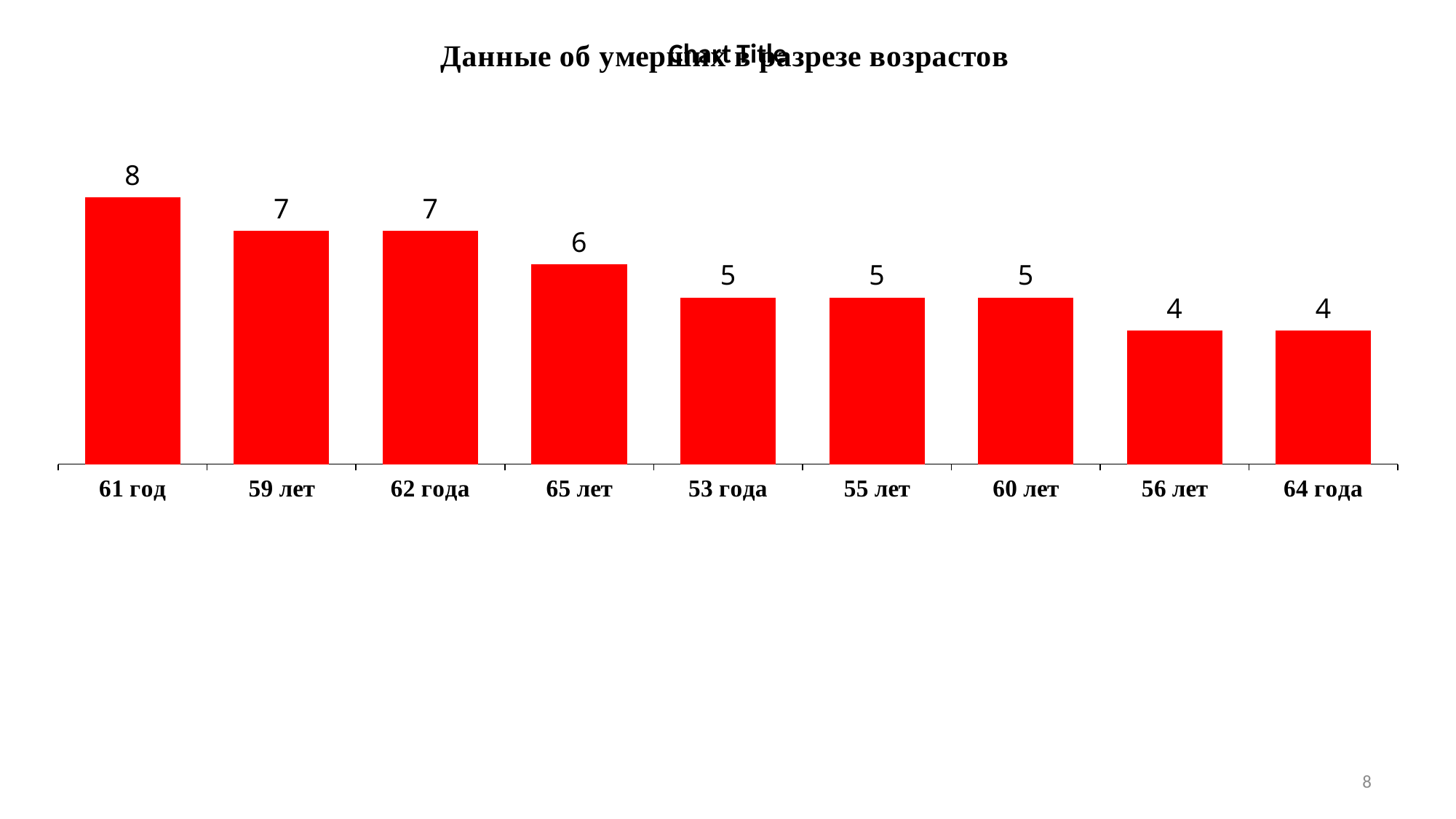
What is the difference between the values for 61 год and 64 года? 4 What is the value for 59 лет? 7 What is the value for 61 год? 8 What kind of chart is shown on the slide? bar chart How many categories are shown on the chart? 9 Which category has the highest value? 61 год What is the value for 65 лет? 6 What colour are the bars on the chart? red Which is larger, the value for 65 лет or the value for 60 лет? 65 лет Do the values rise or fall from left to right along the x axis? fall What is the value for 56 лет? 4 What is the difference between the values for 62 года and 53 года? 2